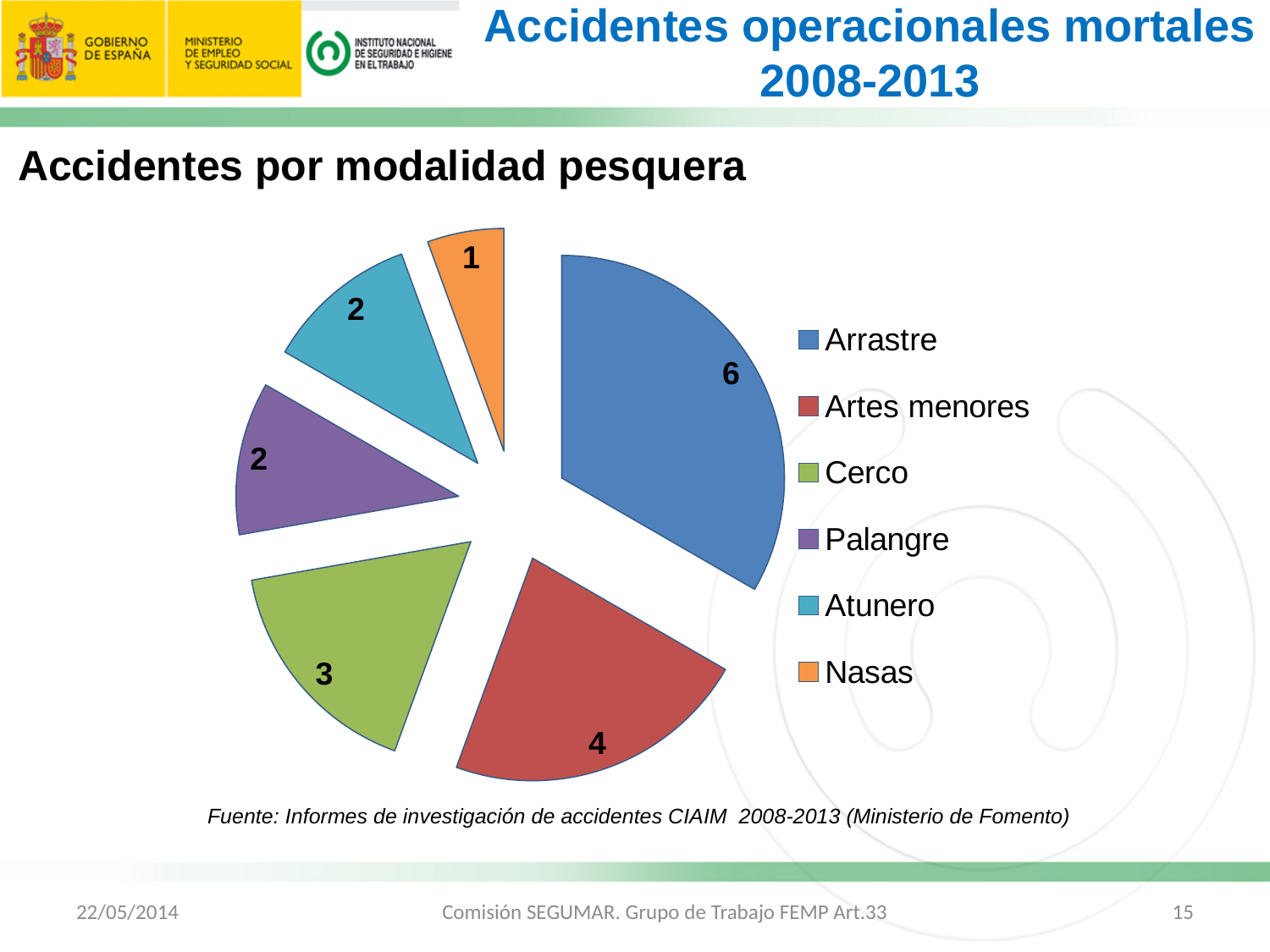
How many accidents are shown for Arrastre? 6 What is the value for Nasas? 1 How many categories does the pie chart have? 6 What colour is the Palangre slice in the pie chart? purple Which fishing modality has the highest number of accidents? Arrastre What kind of chart is shown on the slide? pie chart What is the value for Cerco? 3 What is the total of all the slices in the pie chart? 18 What is the value for Artes menores? 4 Which is larger, the value for Cerco or the value for Atunero? Cerco Which fishing modality has the lowest number of accidents? Nasas What is the difference between the values for Arrastre and Artes menores? 2